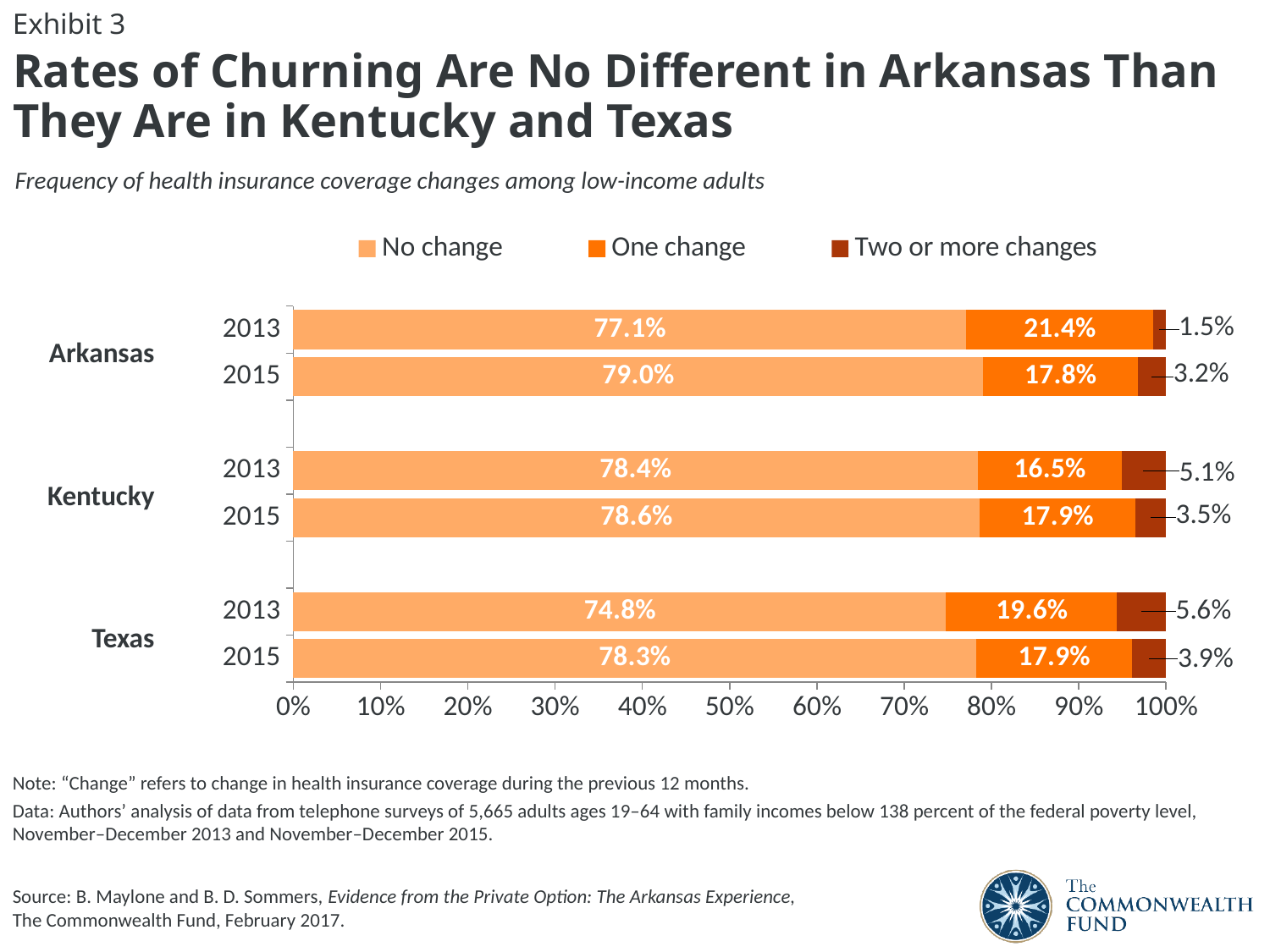
How many series does the legend list? 3 Which is larger: the 'Two or more changes' value for Texas 2013 or for Kentucky 2013? Texas 2013 What kind of chart is shown on the slide? Stacked horizontal bar chart What is the difference between the 'One change' values for Arkansas in 2013 and Arkansas in 2015? 3.6 percentage points How many bars are plotted in the chart? 6 What percentage of low-income adults in Arkansas in 2013 had no change in health insurance coverage? 77.1% Which state-year bar has the highest 'No change' value? Arkansas 2015 Is the 'No change' value for Texas in 2013 greater or less than 70%? greater Which state-year bar has the lowest 'Two or more changes' value? Arkansas 2013 Which legend entry is shown in the darkest colour? Two or more changes What is the value for 'Two or more changes' for Texas in 2015? 3.9% What is the 'One change' value for Kentucky in 2013? 16.5%